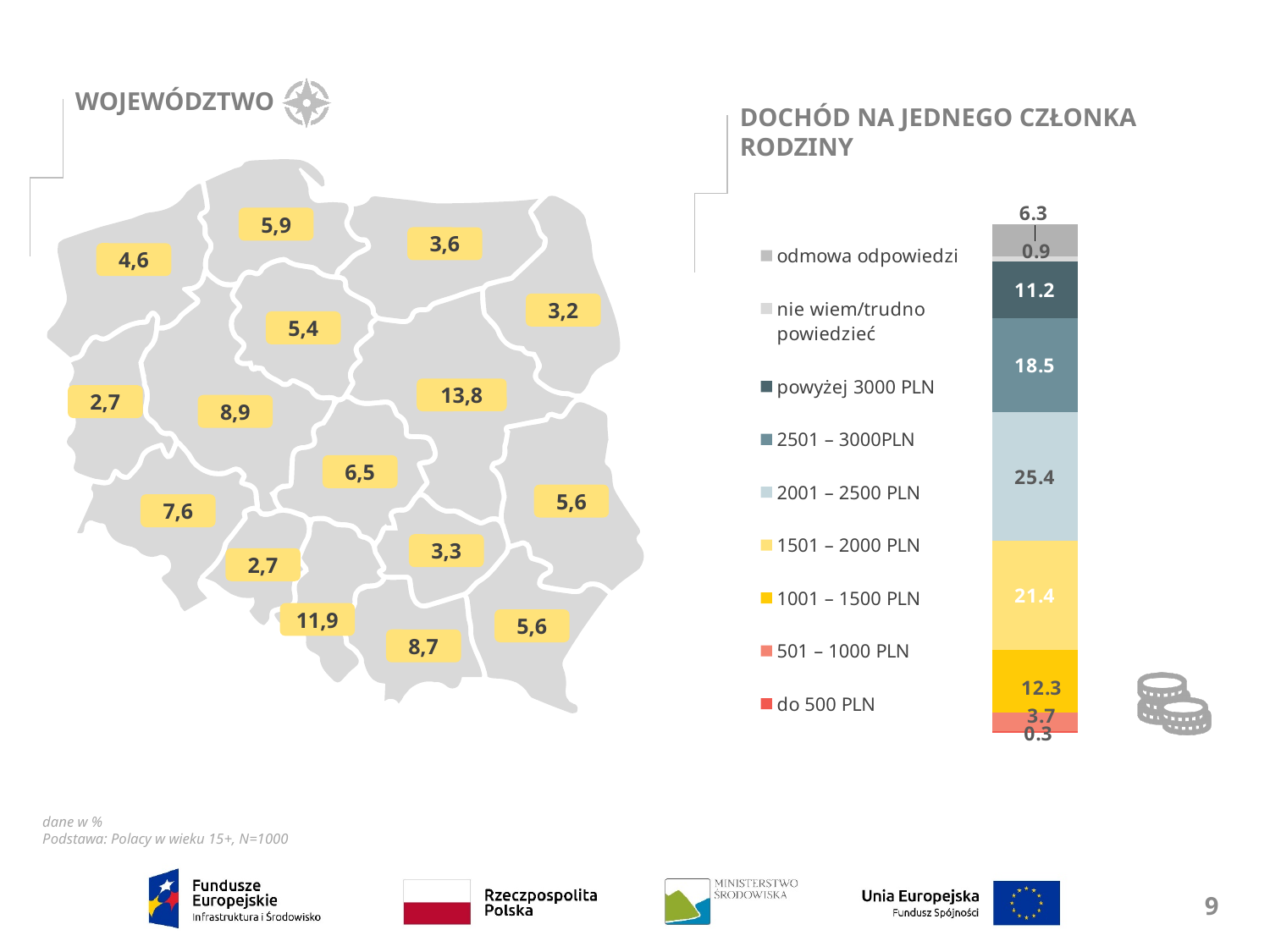
In the chart 'DOCHÓD NA JEDNEGO CZŁONKA RODZINY', what is the difference between the 2001 – 2500 PLN and 1501 – 2000 PLN segments? 4.0 In the chart 'DOCHÓD NA JEDNEGO CZŁONKA RODZINY', what is the value for the 1001 – 1500 PLN segment? 12.3 In the chart 'DOCHÓD NA JEDNEGO CZŁONKA RODZINY', what is the total of all segments in the stacked bar? 100.0 What kind of chart is 'DOCHÓD NA JEDNEGO CZŁONKA RODZINY'? Stacked bar chart In the chart 'DOCHÓD NA JEDNEGO CZŁONKA RODZINY', which income category has the smallest share? do 500 PLN In the chart 'DOCHÓD NA JEDNEGO CZŁONKA RODZINY', what is the value for the do 500 PLN segment? 0.3 In the chart 'DOCHÓD NA JEDNEGO CZŁONKA RODZINY', what is the value for the 2001 – 2500 PLN segment? 25.4 How many entries does the legend of the chart 'DOCHÓD NA JEDNEGO CZŁONKA RODZINY' list? 9 In the chart 'DOCHÓD NA JEDNEGO CZŁONKA RODZINY', what is the value for the powyżej 3000 PLN segment? 11.2 In the chart 'DOCHÓD NA JEDNEGO CZŁONKA RODZINY', which is larger: the 2501 – 3000PLN segment or the 1001 – 1500 PLN segment? 2501 – 3000PLN On the map 'WOJEWÓDZTWO', what is the highest value shown? 13,8 In the chart 'DOCHÓD NA JEDNEGO CZŁONKA RODZINY', which income category has the largest share? 2001 – 2500 PLN